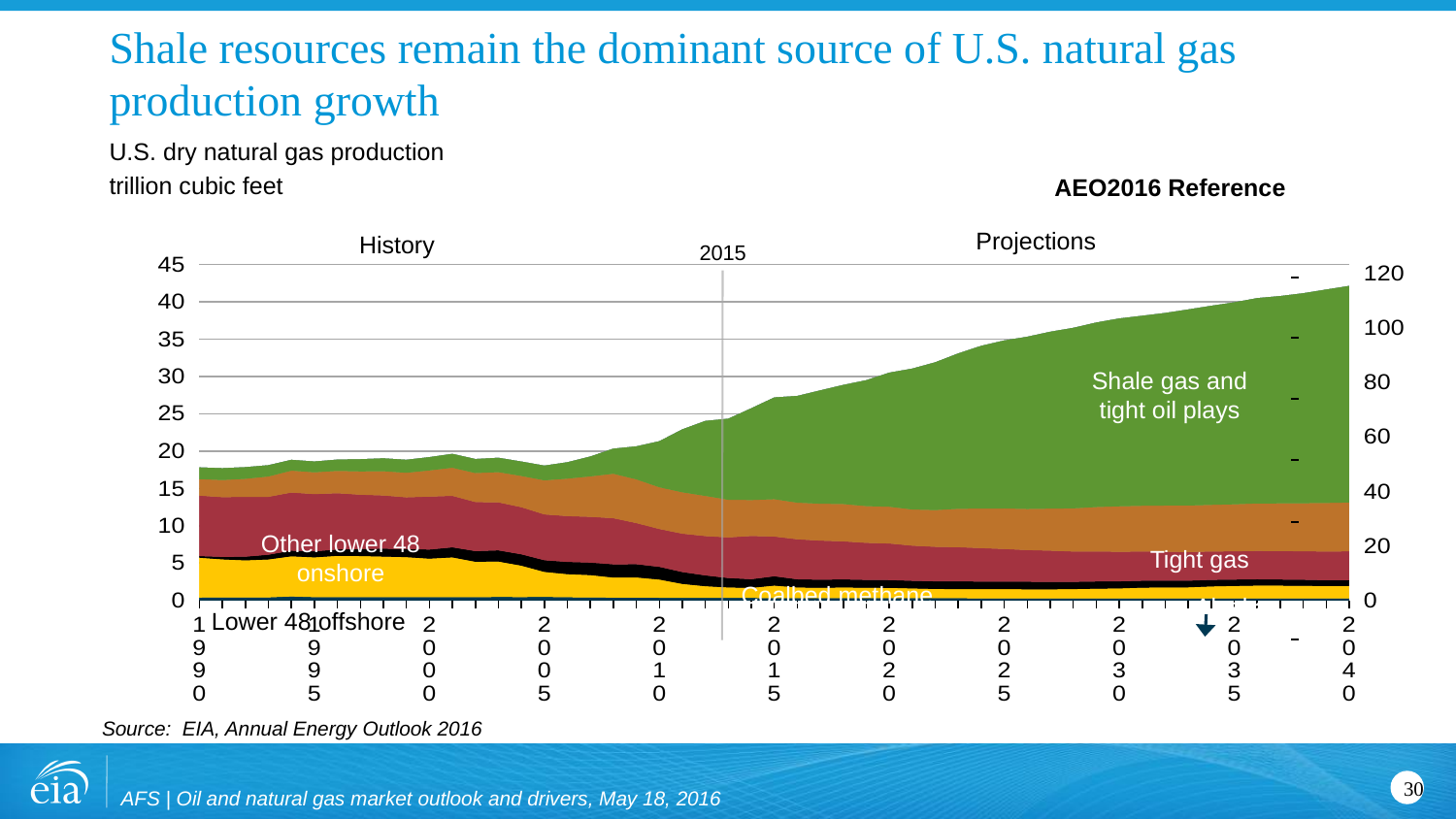
How many year labels are shown on the x axis of the chart? 11 What year does the vertical line separating History from Projections mark? 2015 What kind of chart is shown on the slide? Stacked area chart Is production from shale gas and tight oil plays in 2040 greater or less than 20 trillion cubic feet? greater Which is larger in 2040: production from shale gas and tight oil plays or from tight gas? Shale gas and tight oil plays Is total U.S. dry natural gas production in 2040 greater or less than 40 trillion cubic feet? greater Does total U.S. dry natural gas production rise or fall from 2015 to 2040 in the chart? Rise Is total U.S. dry natural gas production in 2030 greater or less than 30 trillion cubic feet? greater Which series is the largest component of U.S. dry natural gas production in 2040? Shale gas and tight oil plays What is the highest value shown on the left y axis of the chart? 45 Which AEO2016 case is the chart based on? AEO2016 Reference